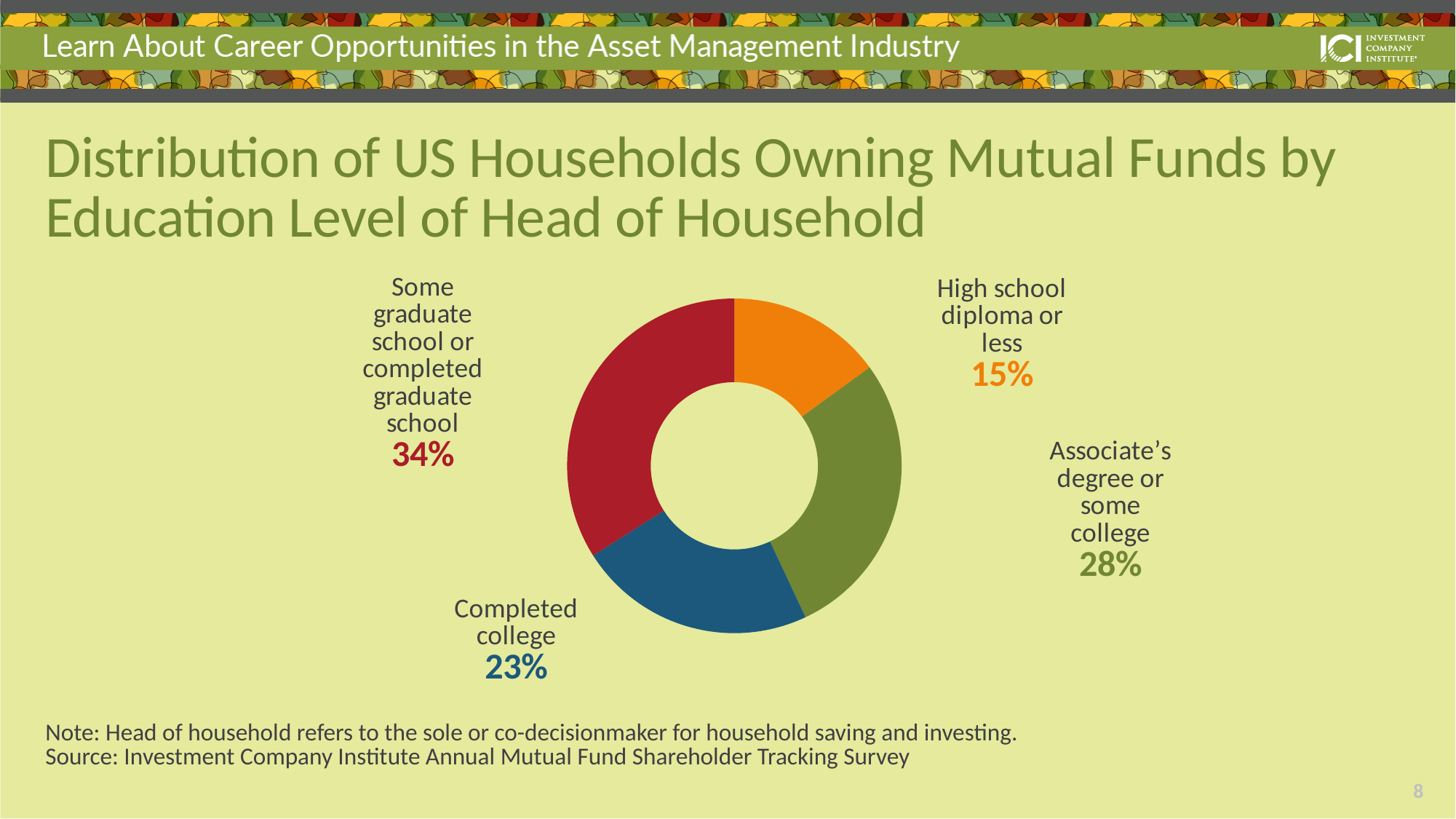
What colour is the slice for 'Completed college'? Blue What share of the chart is the 'Completed college' slice? 23% Which is larger: the share for 'Associate's degree or some college' or the share for 'Completed college'? Associate's degree or some college What kind of chart is shown on the slide? Pie chart (doughnut) What is the difference in percentage points between 'Some graduate school or completed graduate school' and 'High school diploma or less'? 19 How many education level categories are shown in the chart? 4 What percentage of households owning mutual funds have a head of household with an associate's degree or some college? 28% What share of US households owning mutual funds have a head of household with a high school diploma or less? 15% What is the difference in percentage points between 'Associate's degree or some college' and 'Completed college'? 5 Which education level has the largest share of households owning mutual funds? Some graduate school or completed graduate school What percentage is shown for 'Some graduate school or completed graduate school'? 34% Which education level has the smallest share of households owning mutual funds? High school diploma or less